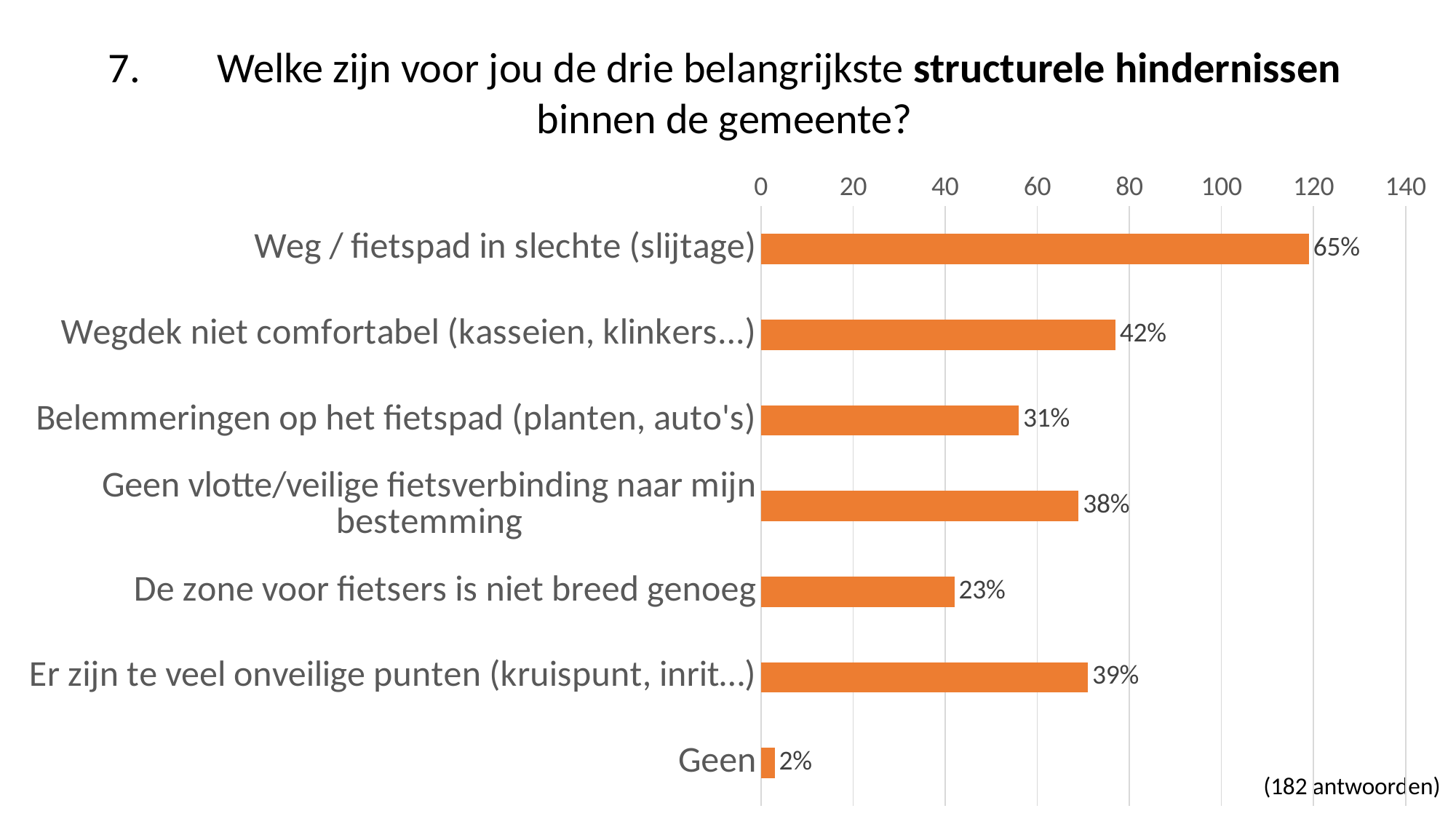
How many responses does the note in the bottom right corner say the chart is based on? 182 antwoorden What is the difference in percentage points between "Weg / fietspad in slechte (slijtage)" (65%) and "Wegdek niet comfortabel (kasseien, klinkers...)" (42%)? 23 percentage points Which is larger: "Wegdek niet comfortabel (kasseien, klinkers...)" or "Belemmeringen op het fietspad (planten, auto's)"? Wegdek niet comfortabel (kasseien, klinkers...) Which category has the highest value? Weg / fietspad in slechte (slijtage) Which category has the lowest value? Geen What type of chart is shown on the slide? Bar chart How many categories are shown in the chart? 7 Is the bar for "De zone voor fietsers is niet breed genoeg" greater or less than 60 on the axis? less What percentage label is shown for "Weg / fietspad in slechte (slijtage)"? 65% What percentage label is shown for "De zone voor fietsers is niet breed genoeg"? 23% What percentage label is shown for "Geen vlotte/veilige fietsverbinding naar mijn bestemming"? 38% Is the bar for "Weg / fietspad in slechte (slijtage)" greater or less than 100 on the axis? greater